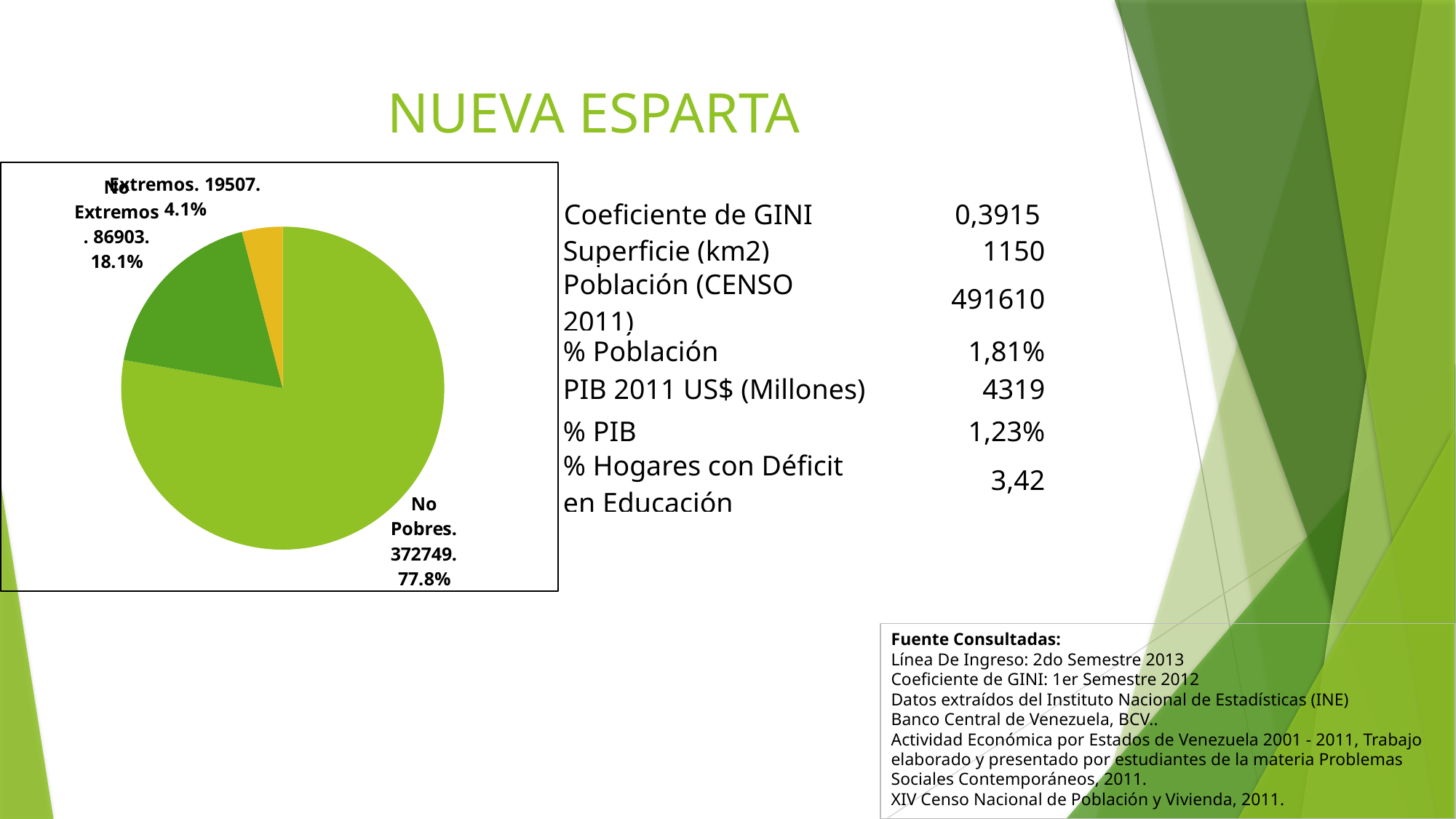
What share of the pie does the Extremos slice represent? 4.1% What share of the pie does the No Pobres slice represent? 77.8% What value is shown for the Extremos slice of the pie chart? 19507 What colour is the Extremos slice of the pie chart? yellow What value is shown for the No Pobres slice of the pie chart? 372749 Which slice of the pie chart is the largest? No Pobres How many slices does the pie chart have? 3 Which is larger in the pie chart, No Extremos or Extremos? No Extremos What value is shown for the No Extremos slice of the pie chart? 86903 Which slice of the pie chart is the smallest? Extremos What kind of chart is shown on the slide? pie chart What is the difference between the No Pobres value and the No Extremos value in the pie chart? 285846